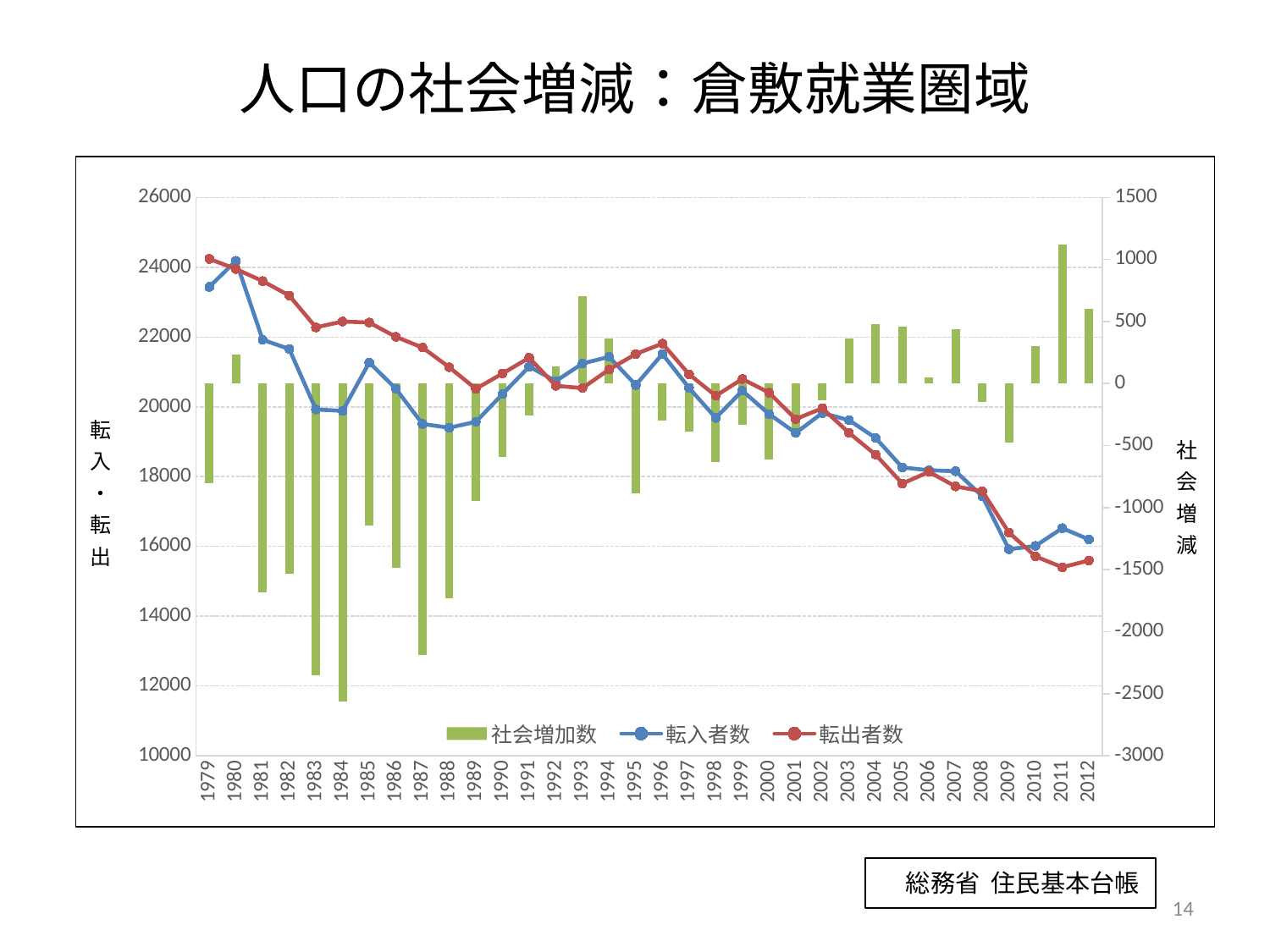
Is the value of 転出者数 in 2012 greater or less than 16000? less In which year is the 社会増加数 bar the highest? 2011 How many years are plotted along the x axis? 34 In which year is 転出者数 at its highest? 1979 Overall, does 転入者数 rise or fall from 1979 to 2012? fall In which year is the 社会増加数 bar the lowest? 1984 Is the 社会増加数 value in 1984 greater or less than -2000? less How many series does the legend list? 3 What is the title of the chart on the slide? 人口の社会増減：倉敷就業圏域 Is the value of 転入者数 in 1979 greater or less than 22000? greater In 1983, which is larger: 転入者数 or 転出者数? 転出者数 What kind of chart is shown on the slide? A combined bar and line chart